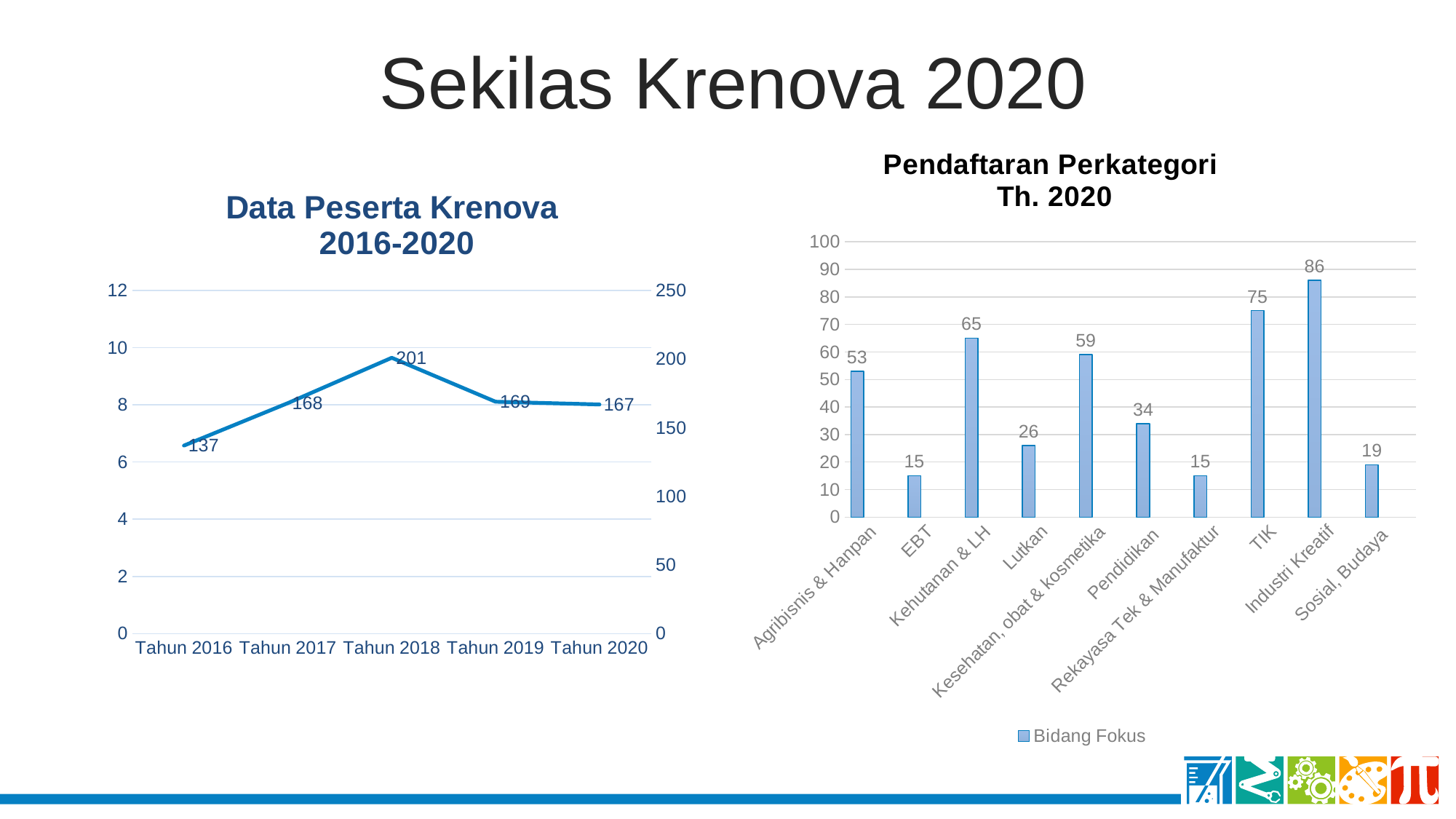
In the 'Pendaftaran Perkategori Th. 2020' chart, what is the value for TIK? 75 In the 'Pendaftaran Perkategori Th. 2020' chart, what is the legend entry? Bidang Fokus In the 'Pendaftaran Perkategori Th. 2020' chart, what is the difference between Industri Kreatif and Pendidikan? 52 In the 'Data Peserta Krenova 2016-2020' chart, how many years are plotted? 5 In the 'Data Peserta Krenova 2016-2020' chart, what is the value for Tahun 2018? 201 In the 'Data Peserta Krenova 2016-2020' chart, what is the value for Tahun 2016? 137 In the 'Pendaftaran Perkategori Th. 2020' chart, how many categories are shown? 10 What kind of chart is 'Data Peserta Krenova 2016-2020'? Line chart In the 'Pendaftaran Perkategori Th. 2020' chart, which category has the highest value? Industri Kreatif In the 'Data Peserta Krenova 2016-2020' chart, which year has the highest value? Tahun 2018 In the 'Pendaftaran Perkategori Th. 2020' chart, which is larger, Kehutanan & LH or Kesehatan, obat & kosmetika? Kehutanan & LH In the 'Data Peserta Krenova 2016-2020' chart, what is the difference between the values for Tahun 2018 and Tahun 2016? 64